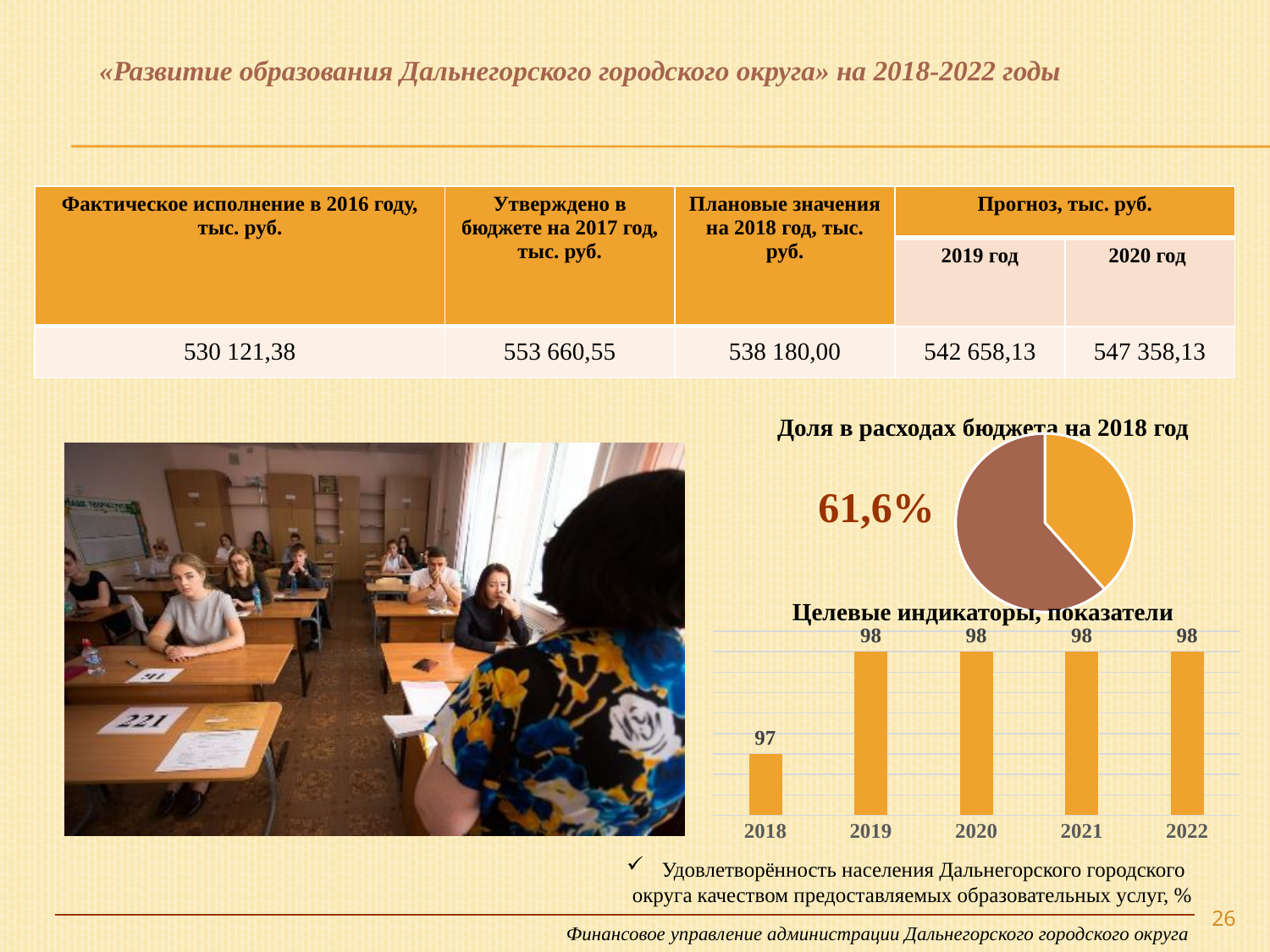
How many years are shown on the x axis of the bar chart 'Целевые индикаторы, показатели'? 5 In the bar chart 'Целевые индикаторы, показатели', what is the difference between the values for 2019 and 2018? 1 In the bar chart 'Целевые индикаторы, показатели', which year has the lowest value? 2018 In the bar chart 'Целевые индикаторы, показатели', what is the value for 2022? 98 In the bar chart 'Целевые индикаторы, показатели', what is the value for 2018? 97 In the bar chart 'Целевые индикаторы, показатели', what is the value for 2020? 98 In the bar chart 'Целевые индикаторы, показатели', do the values rise or fall from 2018 to 2019? rise What kind of chart is 'Доля в расходах бюджета на 2018 год'? pie chart In the bar chart 'Целевые индикаторы, показатели', which is larger, the value for 2018 or the value for 2021? 2021 How many slices does the pie chart 'Доля в расходах бюджета на 2018 год' have? 2 What kind of chart is 'Целевые индикаторы, показатели'? bar chart In the pie chart 'Доля в расходах бюджета на 2018 год', what share is labelled on the chart? 61,6%